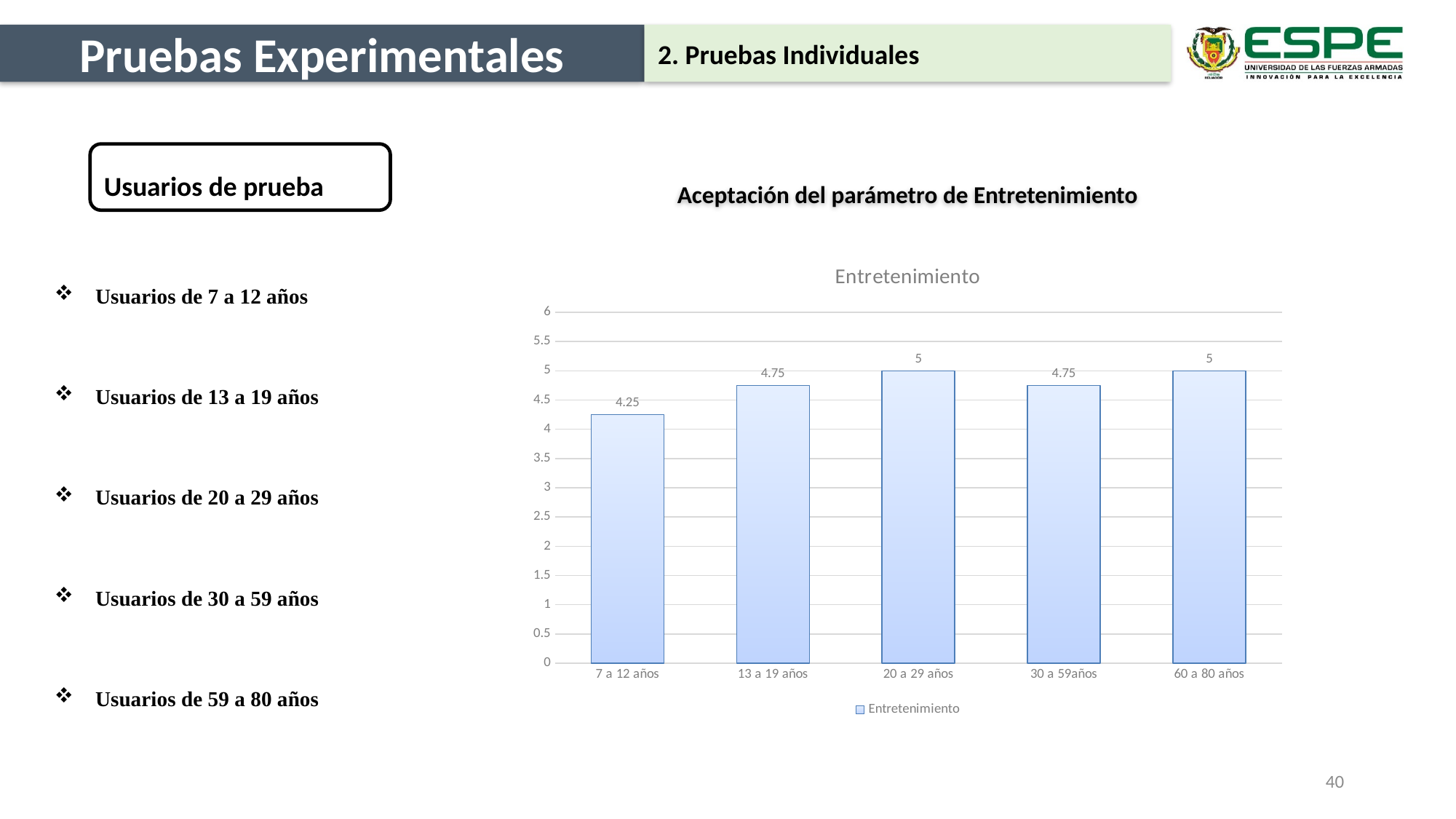
What is the value for the 13 a 19 años category? 4.75 Is the value for 7 a 12 años greater or less than 4.5? less Which category has the lowest value? 7 a 12 años What is the value for the 20 a 29 años category? 5 What is the difference between the values for 20 a 29 años and 7 a 12 años? 0.75 Which is larger, the value for 13 a 19 años or the value for 7 a 12 años? 13 a 19 años How many categories are shown on the x axis? 5 What is the title of the chart? Entretenimiento How many series does the legend list? 1 What is the value for the 7 a 12 años category? 4.25 What is the value for the 30 a 59años category? 4.75 What kind of chart is shown? bar chart